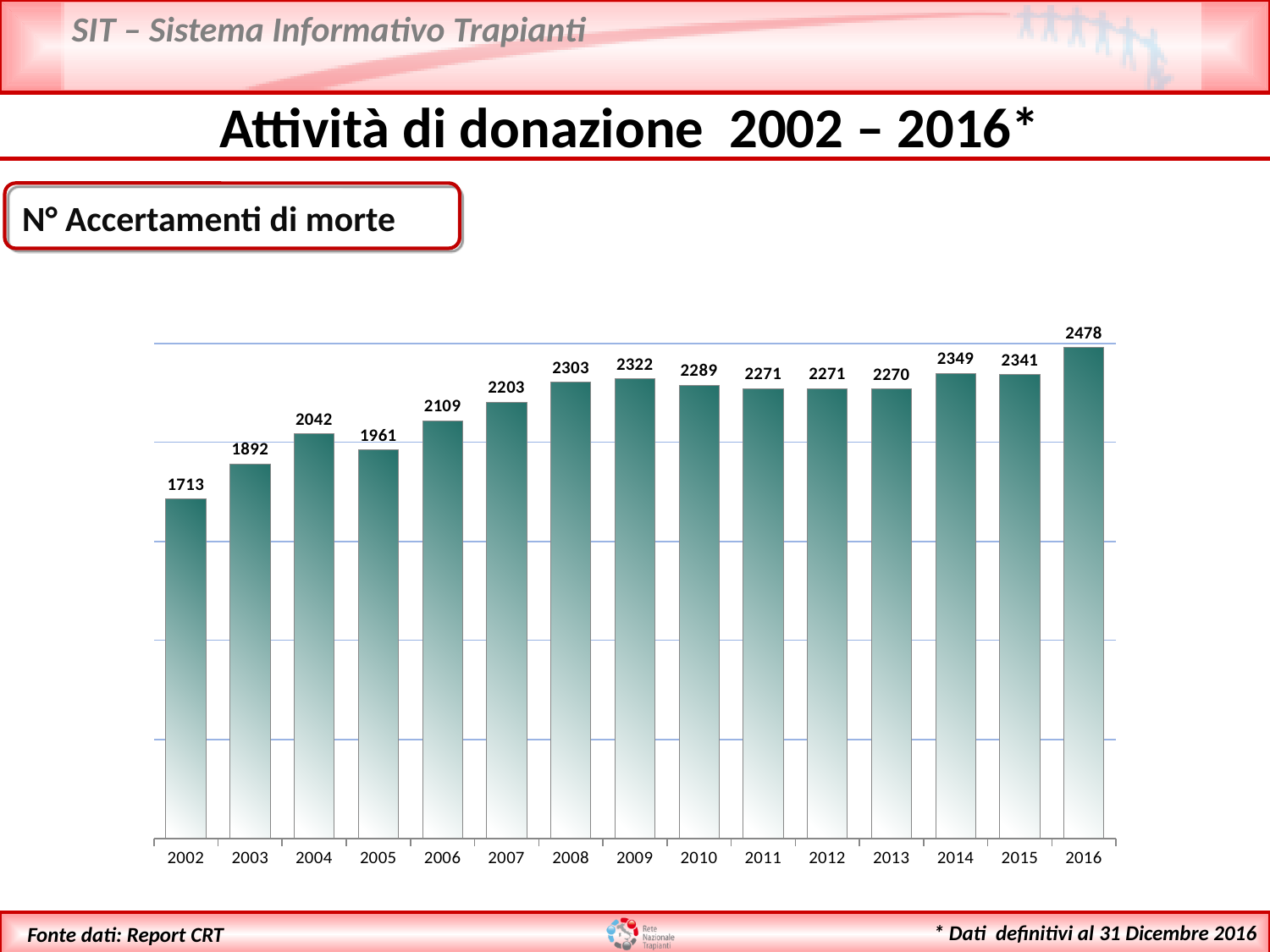
Which year has the lowest number of accertamenti di morte? 2002 What is the label in the box above the chart? N° Accertamenti di morte What is the difference between the values for 2014 and 2015? 8 What is the value shown for 2016? 2478 What is the value shown for 2009? 2322 What kind of chart is shown on the slide? Bar chart How many years are shown on the x axis? 15 Do the values generally rise or fall from 2002 to 2016? Rise What is the number of accertamenti di morte in 2002? 1713 What is the difference between the values for 2016 and 2002? 765 Which year has the highest number of accertamenti di morte? 2016 Which year has a larger value, 2004 or 2005? 2004